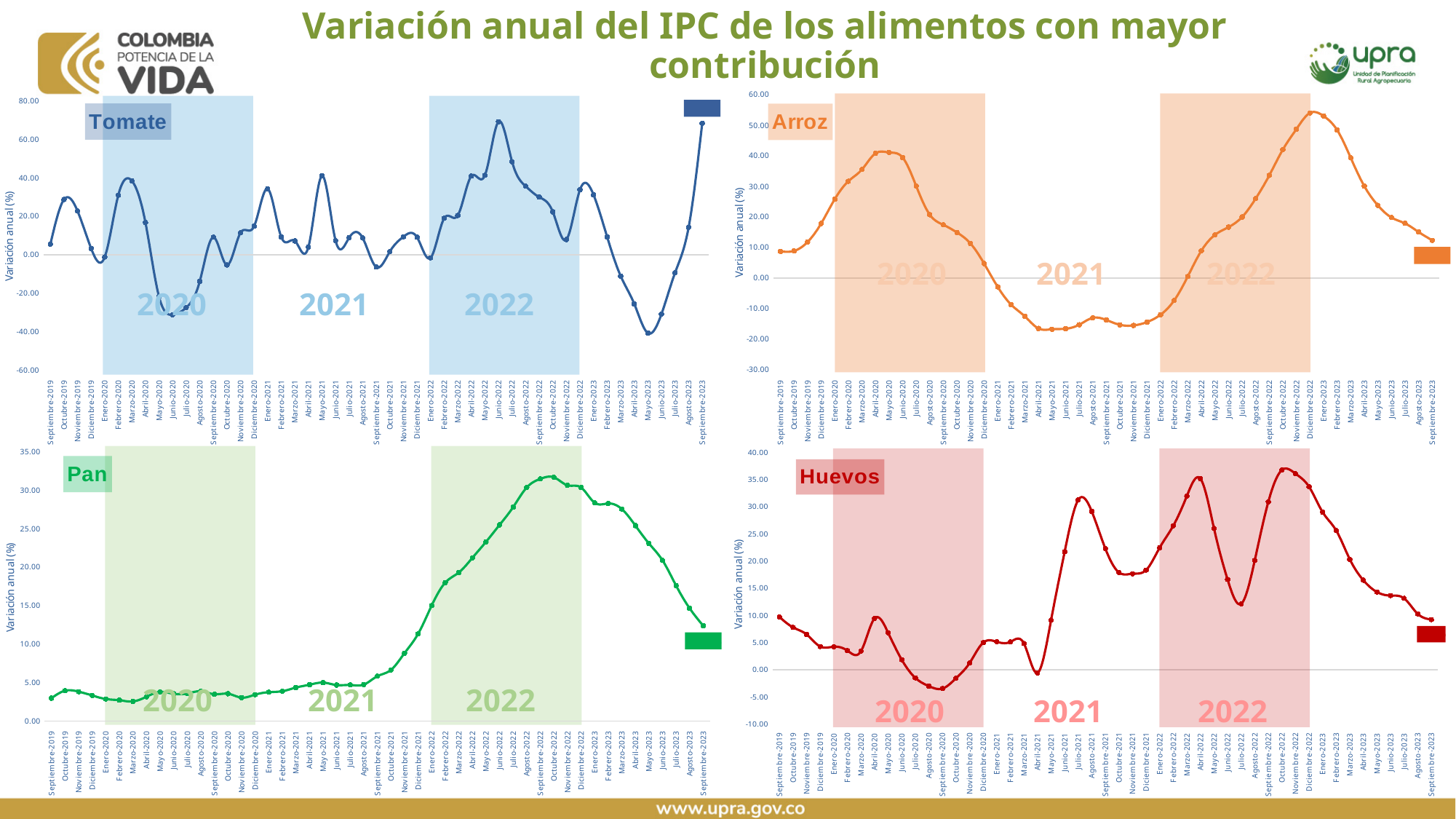
In the Pan chart, do the values rise or fall from Enero-2022 to Octubre-2022? rise In the Pan chart, is the value for Octubre-2022 greater or less than 25.00? greater In the Tomate chart, is the value for Septiembre-2023 greater or less than 40.00? greater What kind of chart is the Tomate chart? line chart In the Huevos chart, is the value for Octubre-2022 greater or less than 30.00? greater How many charts are shown on the slide? 4 What is the title of the slide's set of charts? Variación anual del IPC de los alimentos con mayor contribución In the Arroz chart, do the values rise or fall from Diciembre-2022 to Septiembre-2023? fall